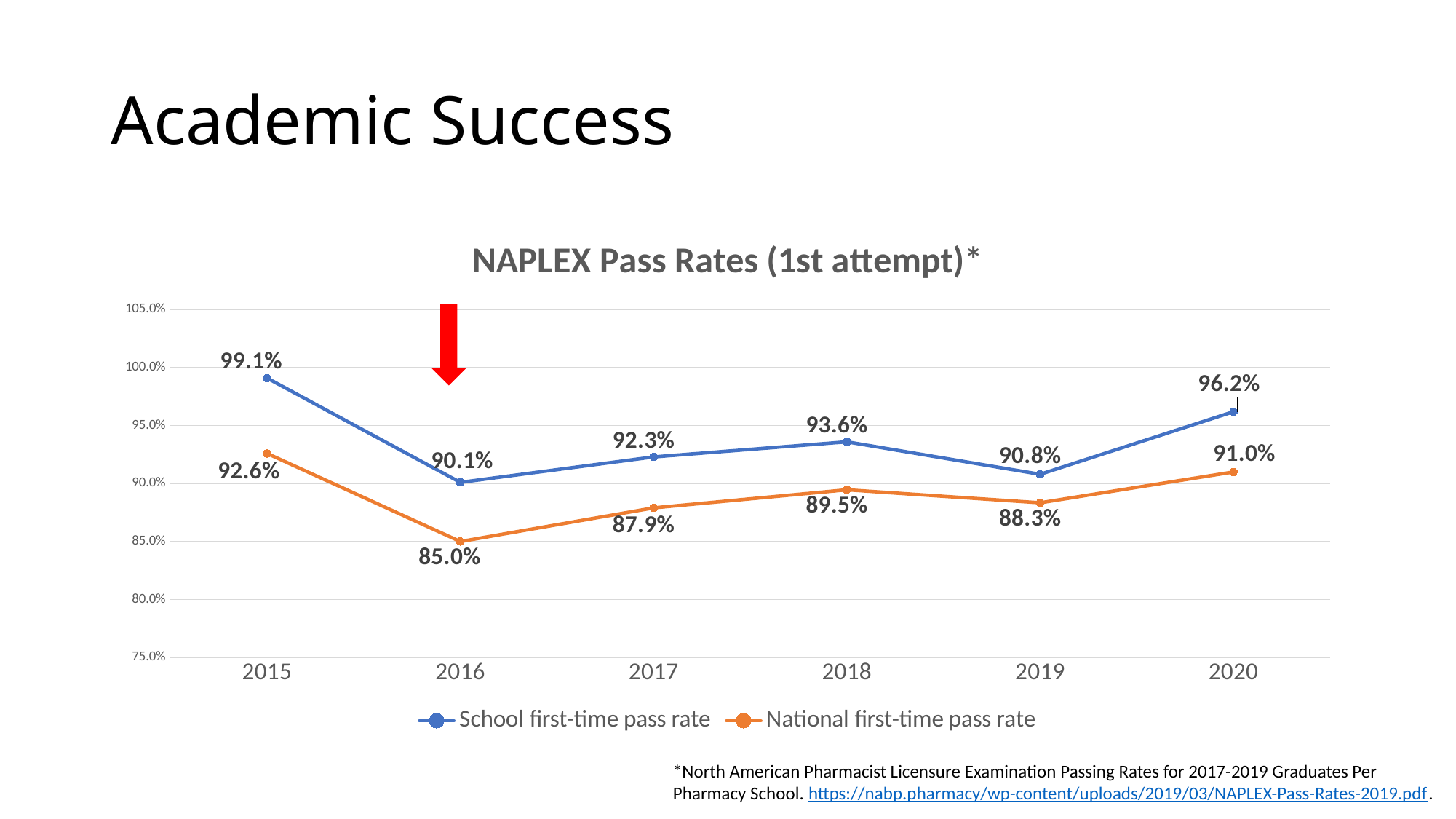
What is the title of the chart? NAPLEX Pass Rates (1st attempt)* In which year was the National first-time pass rate highest? 2015 What was the School first-time pass rate in 2015? 99.1% What was the National first-time pass rate in 2016? 85.0% What kind of chart is shown? Line chart In which year was the School first-time pass rate lowest? 2016 Which was higher in 2019, the School first-time pass rate or the National first-time pass rate? School first-time pass rate What was the School first-time pass rate in 2020? 96.2% How many series does the legend list? 2 How many years are shown on the x axis? 6 What was the National first-time pass rate in 2018? 89.5% What is the difference between the School and National first-time pass rates in 2016? 5.1%